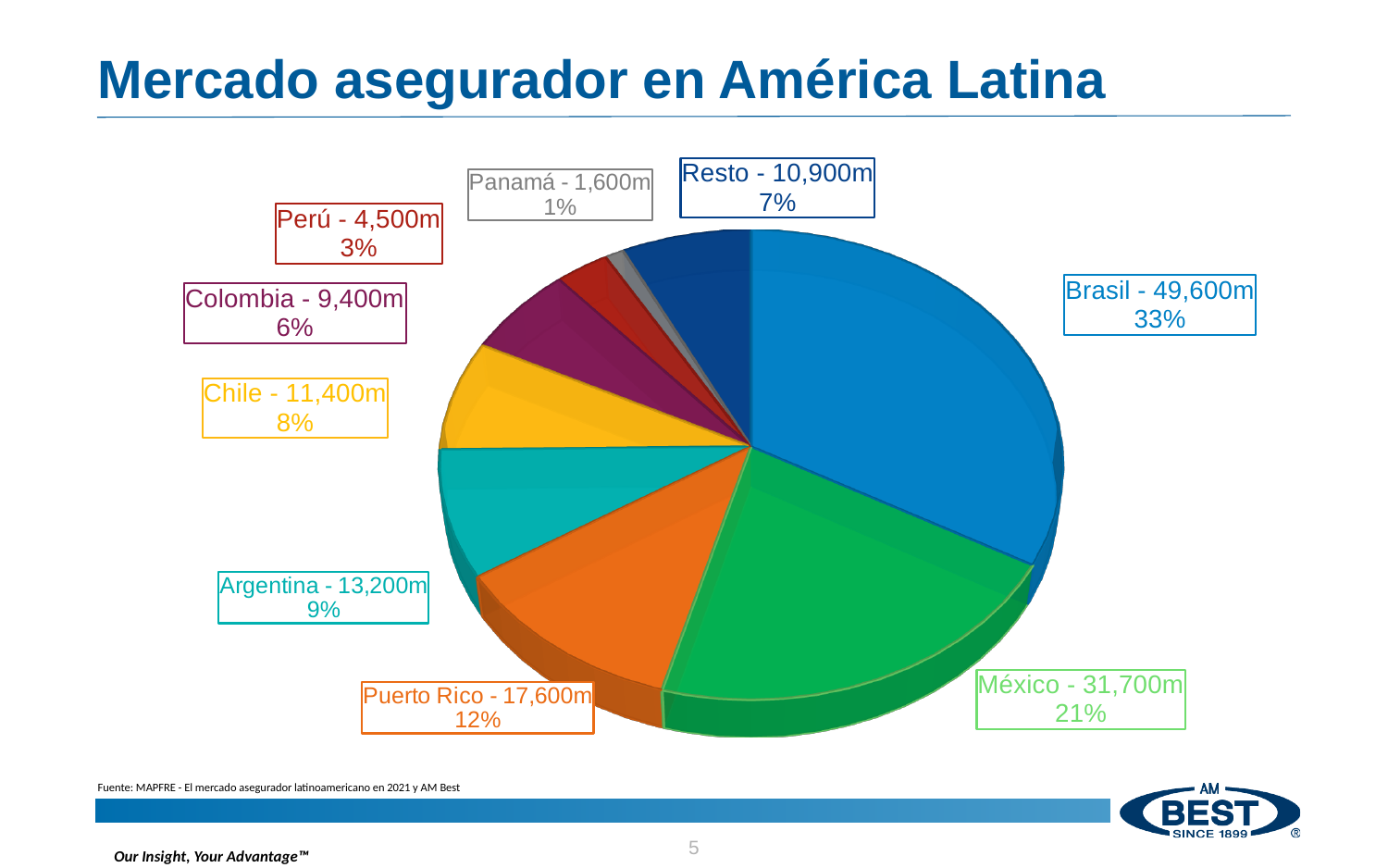
What is the title of the slide containing the chart? Mercado asegurador en América Latina What is the value shown for Resto? 10,900m Which category has the smallest slice of the pie? Panamá What share of the pie does Argentina represent? 9% What is the value shown for Brasil? 49,600m Which is larger, the value for Chile or the value for Colombia? Chile What share of the pie does México represent? 21% What is the difference between the values for Brasil and México? 17,900m How many slices does the pie chart have? 9 What is the value shown for Puerto Rico? 17,600m Which category has the largest slice of the pie? Brasil What kind of chart is shown on the slide? Pie chart